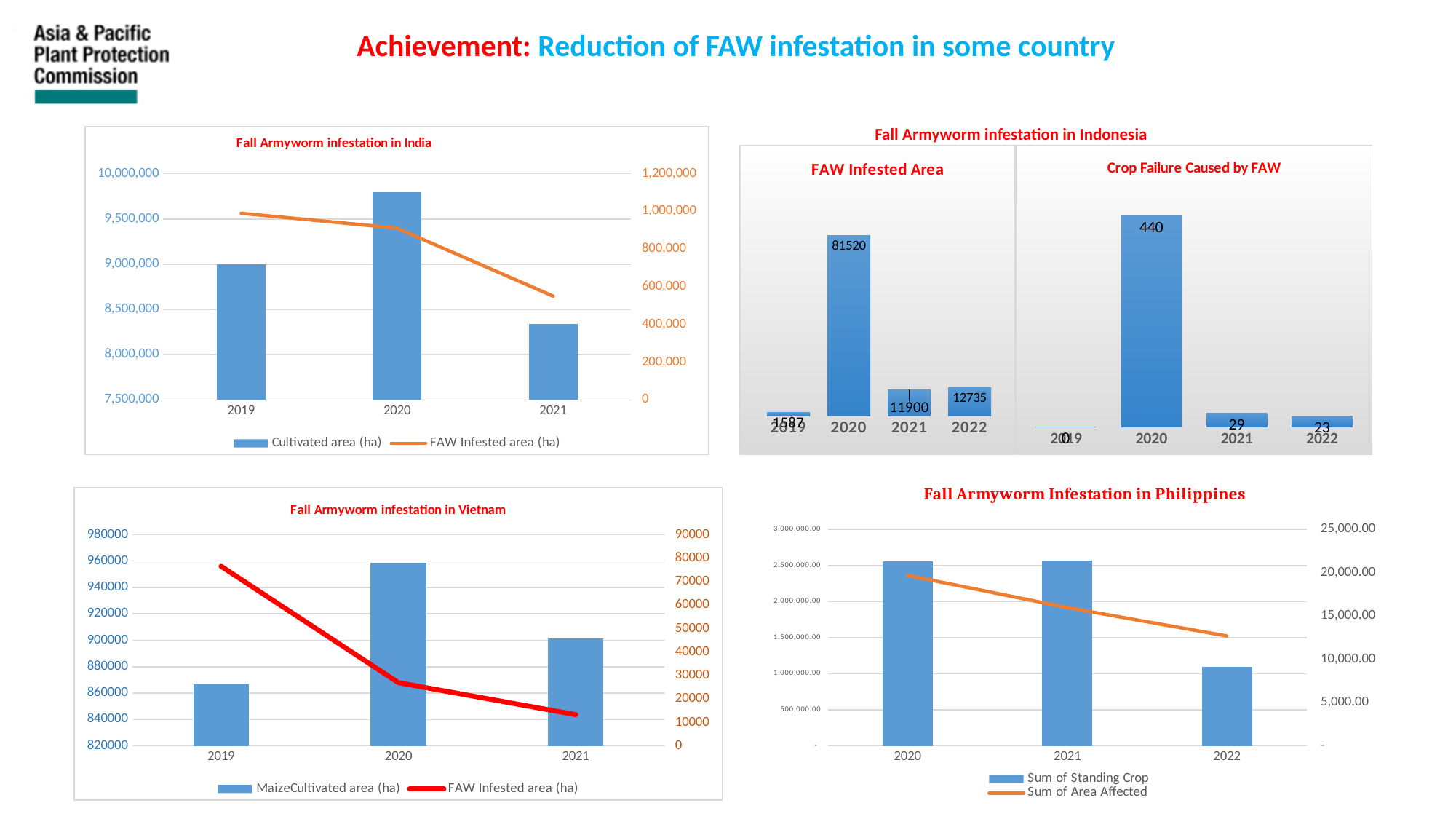
In the Fall Armyworm infestation in Indonesia chart, what is the Crop Failure Caused by FAW value for 2021? 29 In the Fall Armyworm infestation in Indonesia chart, what is the FAW Infested Area value for 2020? 81520 In the Fall Armyworm infestation in Indonesia chart, which year has the highest FAW Infested Area? 2020 In the Fall Armyworm infestation in India chart, which year has the highest Cultivated area (ha)? 2020 In the Fall Armyworm Infestation in Philippines chart, is the Sum of Standing Crop for 2022 greater or less than 1,500,000.00? less In the Fall Armyworm infestation in Vietnam chart, how many years are shown on the x axis? 3 In the Fall Armyworm infestation in Vietnam chart, is the FAW Infested area (ha) for 2019 greater or less than 70000? greater In the Fall Armyworm infestation in Indonesia chart, which year has the lowest Crop Failure Caused by FAW? 2019 In the Fall Armyworm infestation in India chart, does the FAW Infested area (ha) rise or fall from 2019 to 2021? fall In the Fall Armyworm Infestation in Philippines chart, how many series does the legend list? 2 In the Fall Armyworm infestation in Indonesia chart, what is the difference between the Crop Failure Caused by FAW values for 2020 and 2021? 411 In the Fall Armyworm infestation in Indonesia chart, what is the difference between the FAW Infested Area values for 2022 and 2021? 835